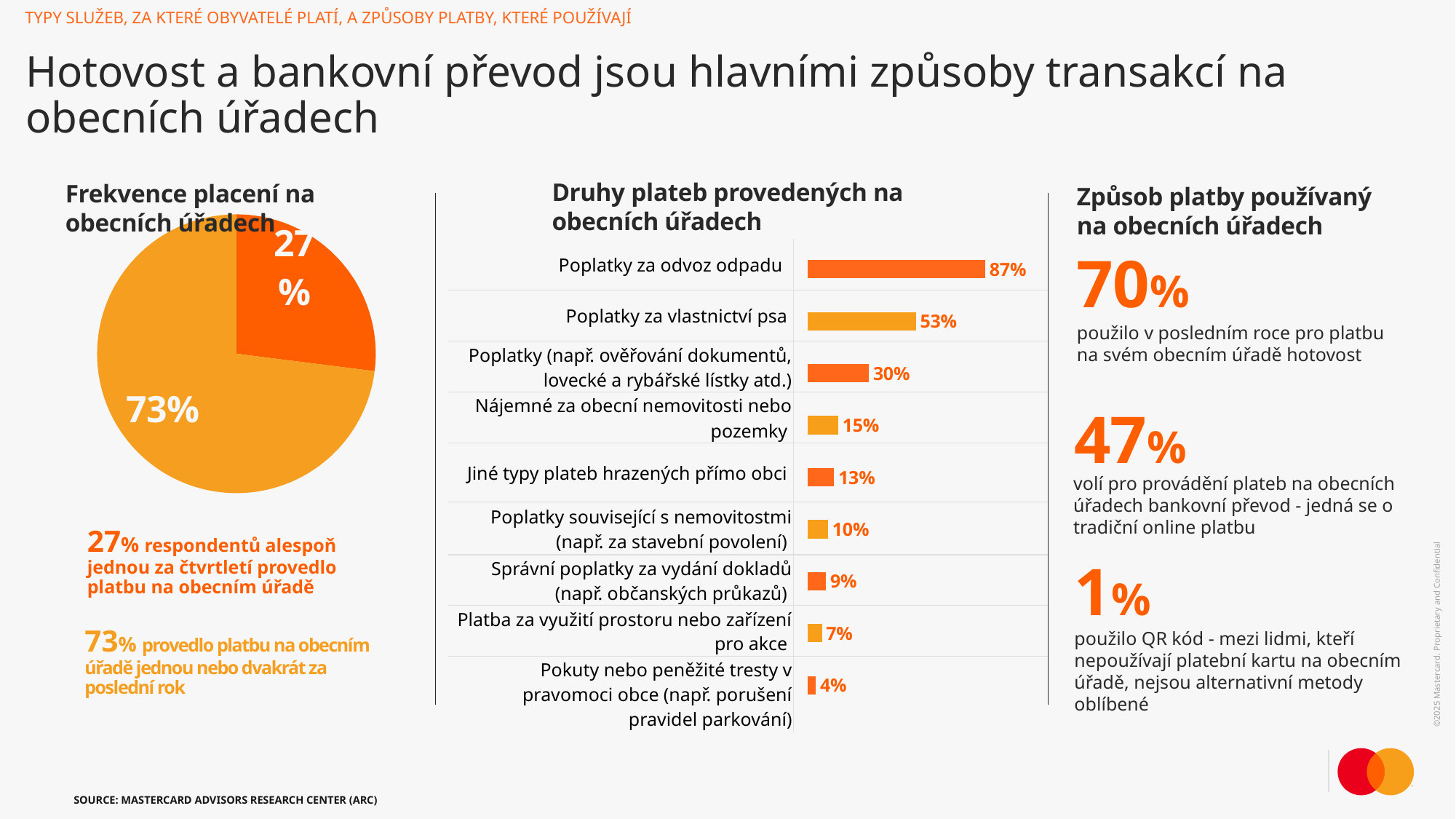
In the pie chart 'Frekvence placení na obecních úřadech', what share does the larger slice represent? 73% In the chart 'Druhy plateb provedených na obecních úřadech', what is the value for 'Poplatky za odvoz odpadu'? 87% In the chart 'Druhy plateb provedených na obecních úřadech', which category has the highest value? Poplatky za odvoz odpadu How many slices does the pie chart 'Frekvence placení na obecních úřadech' have? 2 In the chart 'Druhy plateb provedených na obecních úřadech', what is the value for 'Poplatky za vlastnictví psa'? 53% In the chart 'Druhy plateb provedených na obecních úřadech', what is the difference between the values for 'Poplatky za odvoz odpadu' and 'Poplatky za vlastnictví psa'? 34% What type of chart is 'Druhy plateb provedených na obecních úřadech'? Bar chart In the chart 'Druhy plateb provedených na obecních úřadech', which is larger: 'Jiné typy plateb hrazených přímo obci' or 'Poplatky související s nemovitostmi (např. za stavební povolení)'? Jiné typy plateb hrazených přímo obci In the chart 'Druhy plateb provedených na obecních úřadech', which category has the lowest value? Pokuty nebo peněžité tresty v pravomoci obce (např. porušení pravidel parkování) What type of chart is 'Frekvence placení na obecních úřadech'? Pie chart In the chart 'Druhy plateb provedených na obecních úřadech', what is the value for 'Nájemné za obecní nemovitosti nebo pozemky'? 15% How many categories are shown in the chart 'Druhy plateb provedených na obecních úřadech'? 9